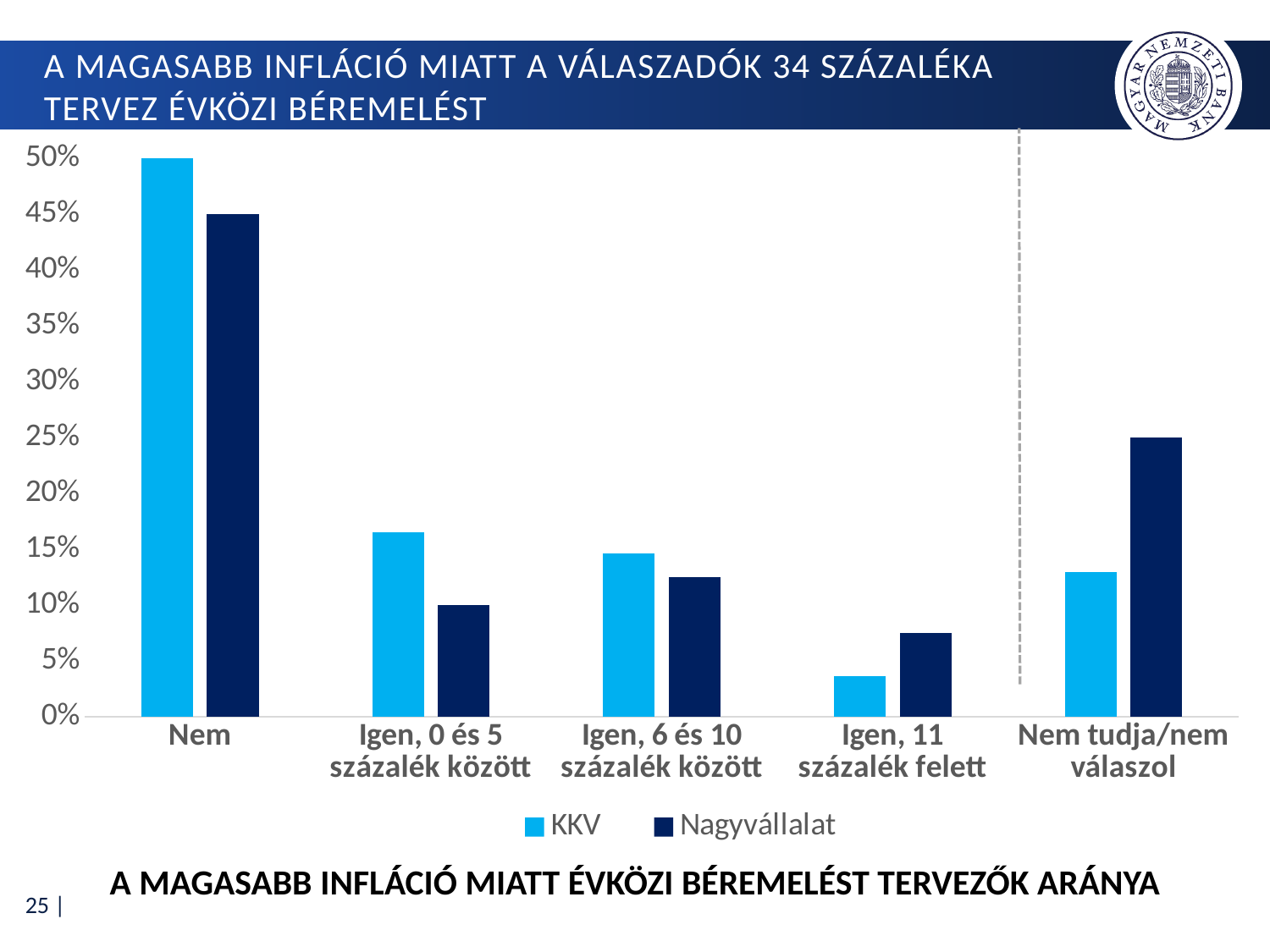
How many categories are shown on the x axis? 5 Which category has the lowest value for the Nagyvállalat series? Igen, 11 százalék felett How many series does the legend list? 2 Which category has the highest value for the KKV series? Nem Is the Nagyvállalat value for 'Nem tudja/nem válaszol' greater or less than 20%? greater What kind of chart is shown on the slide? bar chart What are the two series names listed in the legend? KKV and Nagyvállalat For the category 'Nem', which series has the larger value, KKV or Nagyvállalat? KKV Is the KKV value for 'Igen, 0 és 5 százalék között' greater or less than 15%? greater For the category 'Igen, 11 százalék felett', which series has the larger value, KKV or Nagyvállalat? Nagyvállalat For the category 'Nem tudja/nem válaszol', which series has the larger value, KKV or Nagyvállalat? Nagyvállalat Which category has the lowest value for the KKV series? Igen, 11 százalék felett